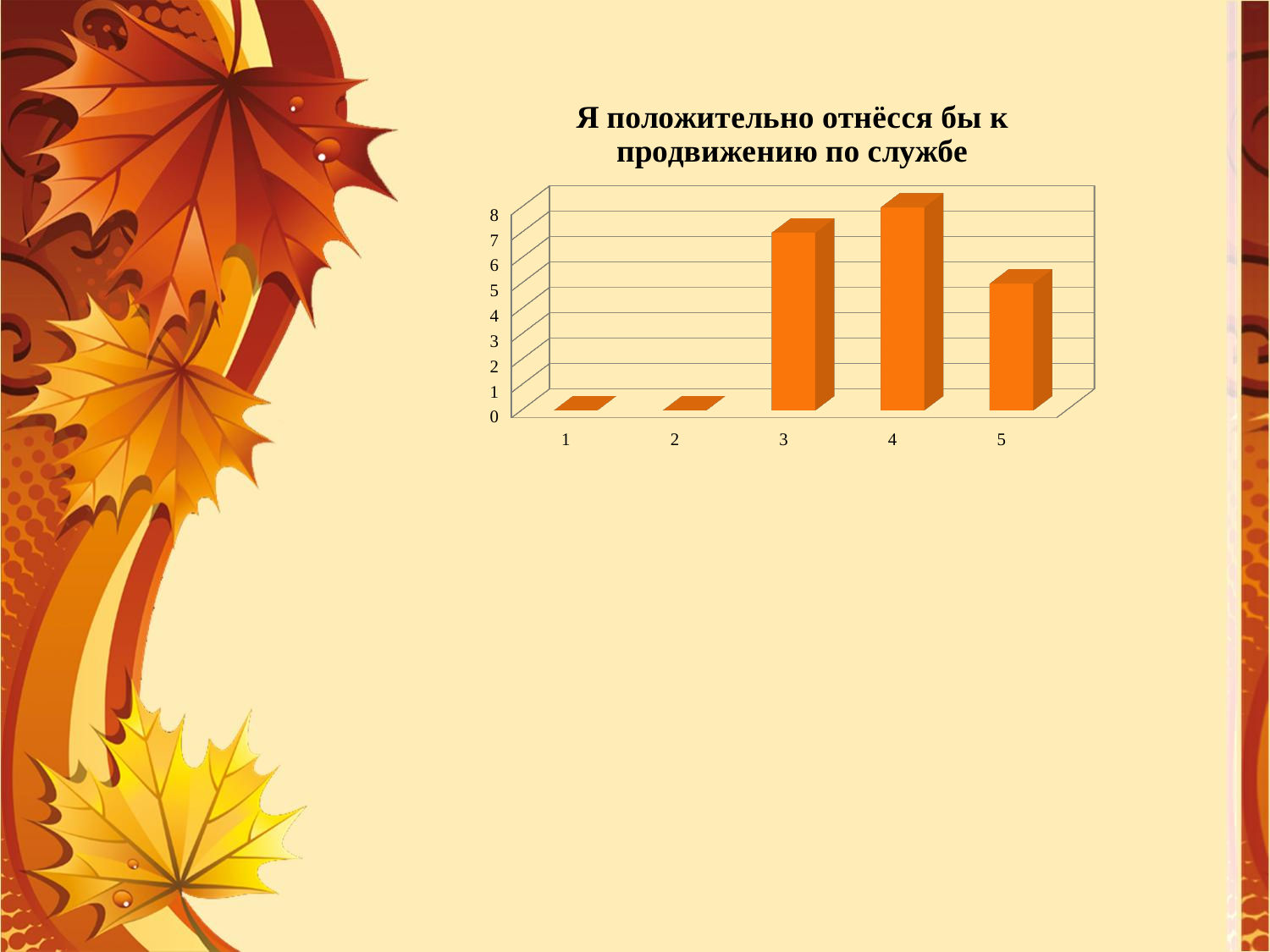
Which is larger, the value for category 4 or the value for category 3? category 4 What is the highest value shown on the vertical axis of the chart? 8 Is the value for category 4 greater or less than 6? greater Is the value for category 5 greater or less than 7? less How many categories are shown on the x axis of the chart? 5 Is the value for category 3 greater or less than 4? greater Which is larger, the value for category 3 or the value for category 5? category 3 What kind of chart is shown on the slide? bar chart Which is larger, the value for category 2 or the value for category 5? category 5 What is the title of the chart? Я положительно отнёсся бы к продвижению по службе Which category has the highest bar in the chart? 4